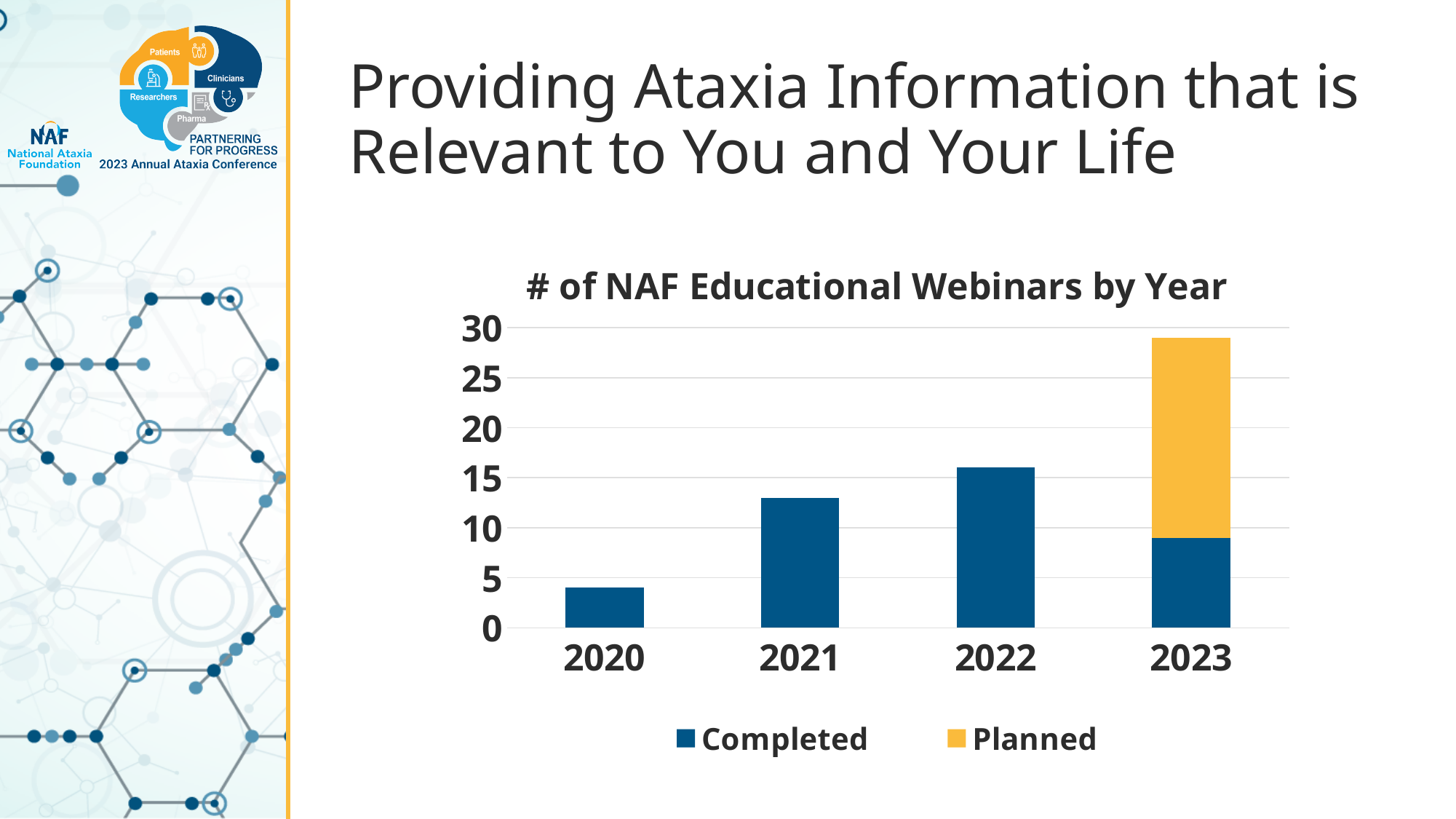
How many years are shown on the x axis of the chart? 4 Do the total bar heights rise or fall from 2020 to 2023? rise Which series are listed in the chart legend? Completed and Planned Is the total height of the 2023 bar greater or less than 25? greater Is the Completed value for 2020 greater or less than 5? less Is the Completed value for 2021 greater or less than 10? greater Which year has more Completed webinars, 2021 or 2022? 2022 Which year has the tallest bar in the chart? 2023 How many series does the chart legend list? 2 Which year has the shortest bar in the chart? 2020 What kind of chart is shown on the slide? Stacked bar chart What is the title of the chart? # of NAF Educational Webinars by Year